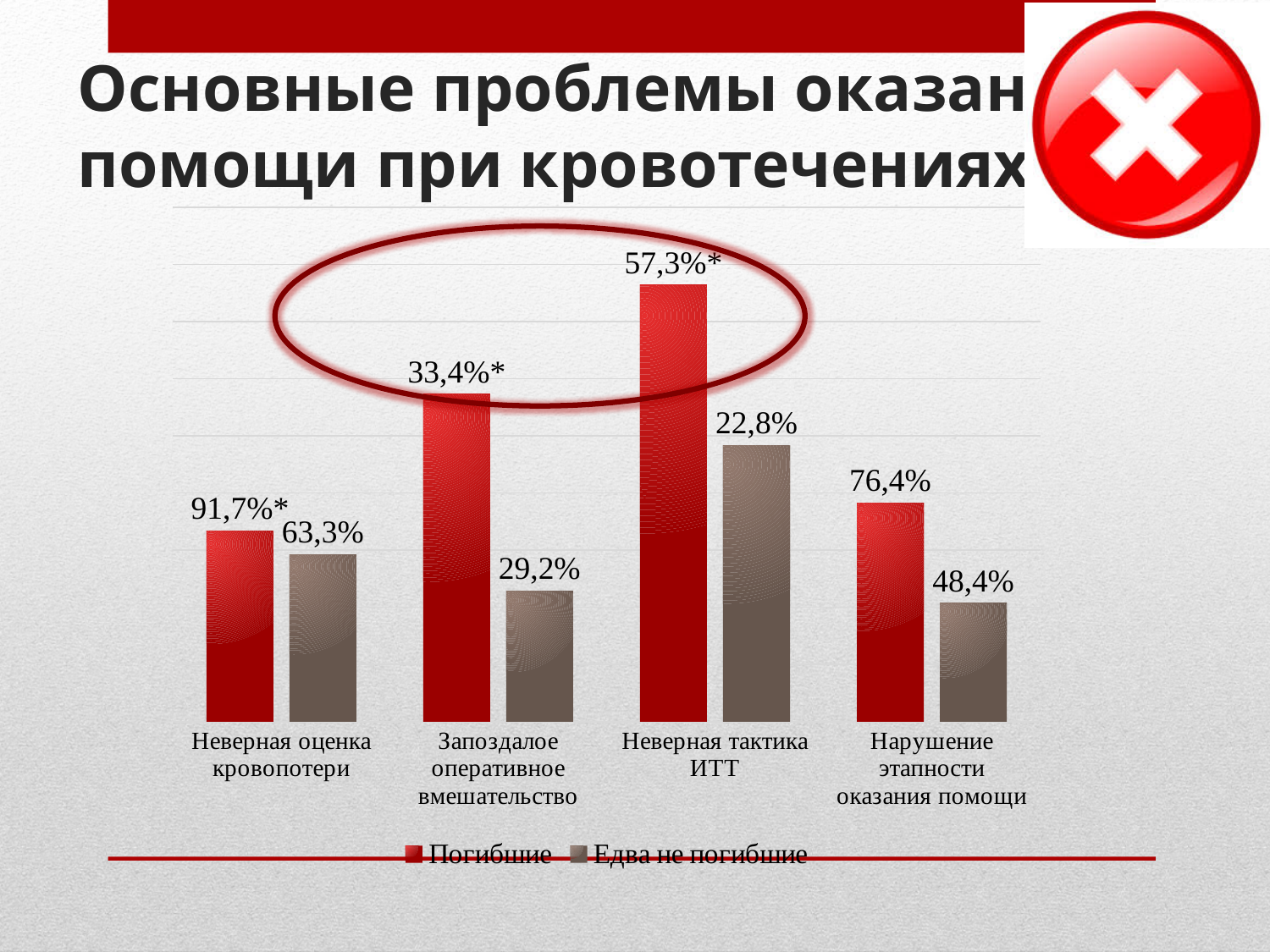
What is the value for Едва не погибшие in the category Запоздалое оперативное вмешательство? 29,2% What is the difference between the Погибшие and Едва не погибшие values in the category Неверная тактика ИТТ? 34,5% Which category has the lowest labelled value for Едва не погибшие? Неверная тактика ИТТ What is the difference between the Погибшие and Едва не погибшие values in the category Нарушение этапности оказания помощи? 28,0% What is the value for Едва не погибшие in the category Неверная тактика ИТТ? 22,8% How many categories are shown on the x axis? 4 How many series does the legend list? 2 What colour are the bars for the series Погибшие? red What is the value for Погибшие in the category Неверная оценка кровопотери? 91,7%* What type of chart is shown on the slide? bar chart Which series has the larger value in the category Неверная тактика ИТТ, Погибшие or Едва не погибшие? Погибшие What is the value for Погибшие in the category Нарушение этапности оказания помощи? 76,4%